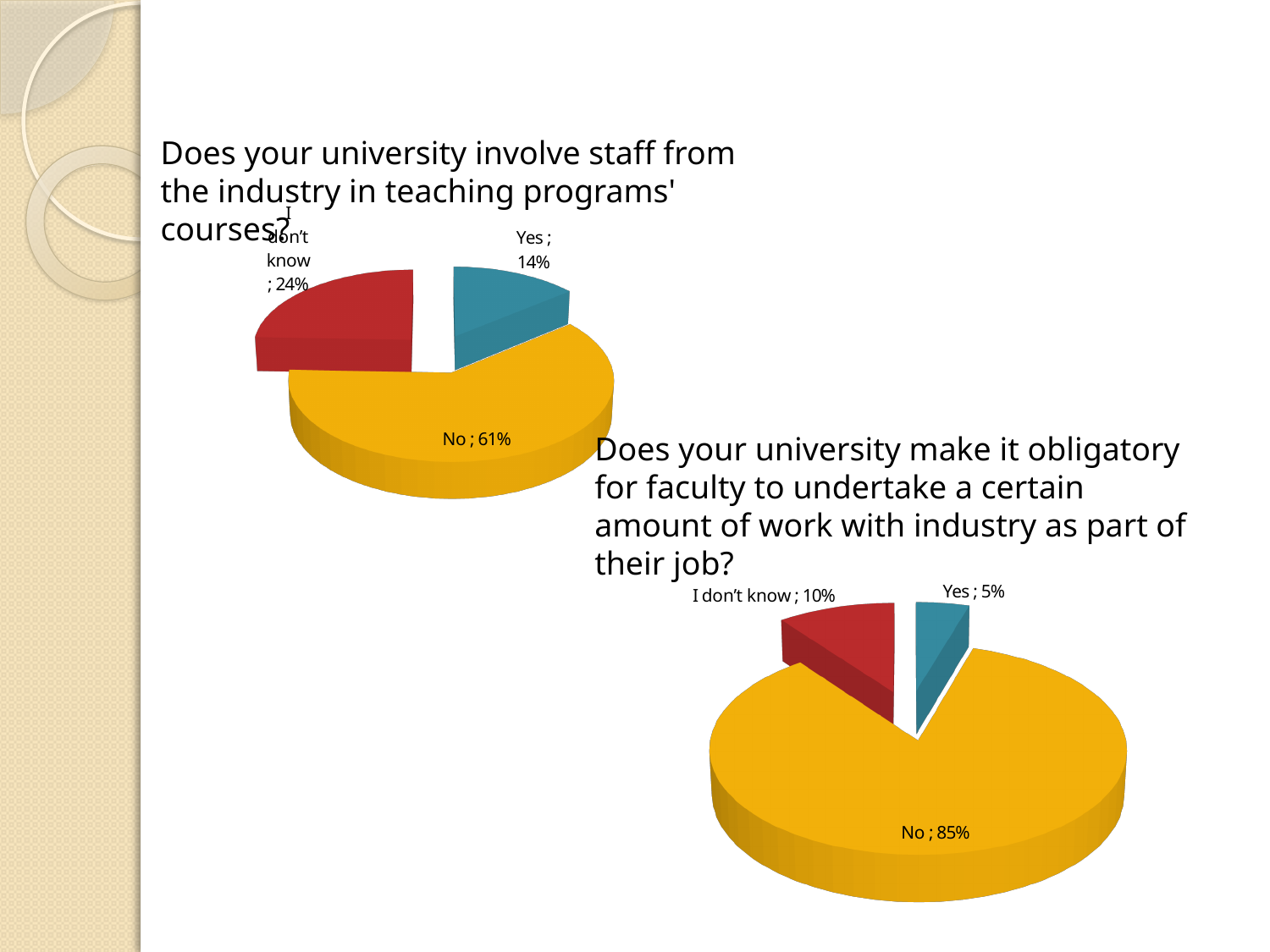
In the bottom-right pie chart about obligatory work with industry, what percentage answered "No"? 85% In the bottom-right pie chart about obligatory work with industry, which response has the smallest share? Yes In the bottom-right pie chart about obligatory work with industry, what is the difference between the "I don't know" and "Yes" percentages? 5% Which chart has the larger "No" share: the top-left chart about involving industry staff in teaching, or the bottom-right chart about obligatory work with industry? The bottom-right chart In the top-left pie chart about involving industry staff in teaching courses, which response has the largest share? No In the bottom-right pie chart about obligatory work with industry, what percentage answered "I don't know"? 10% In the top-left pie chart about involving industry staff in teaching courses, what percentage answered "Yes"? 14% In the top-left pie chart about involving industry staff in teaching courses, what is the difference between the "No" and "Yes" percentages? 47% In the top-left pie chart about involving industry staff in teaching courses, what percentage answered "I don't know"? 24% What type of chart is used for both charts on the slide? Pie chart In the bottom-right pie chart about obligatory work with industry, what percentage answered "Yes"? 5% In the top-left pie chart about involving industry staff in teaching courses, what percentage answered "No"? 61%